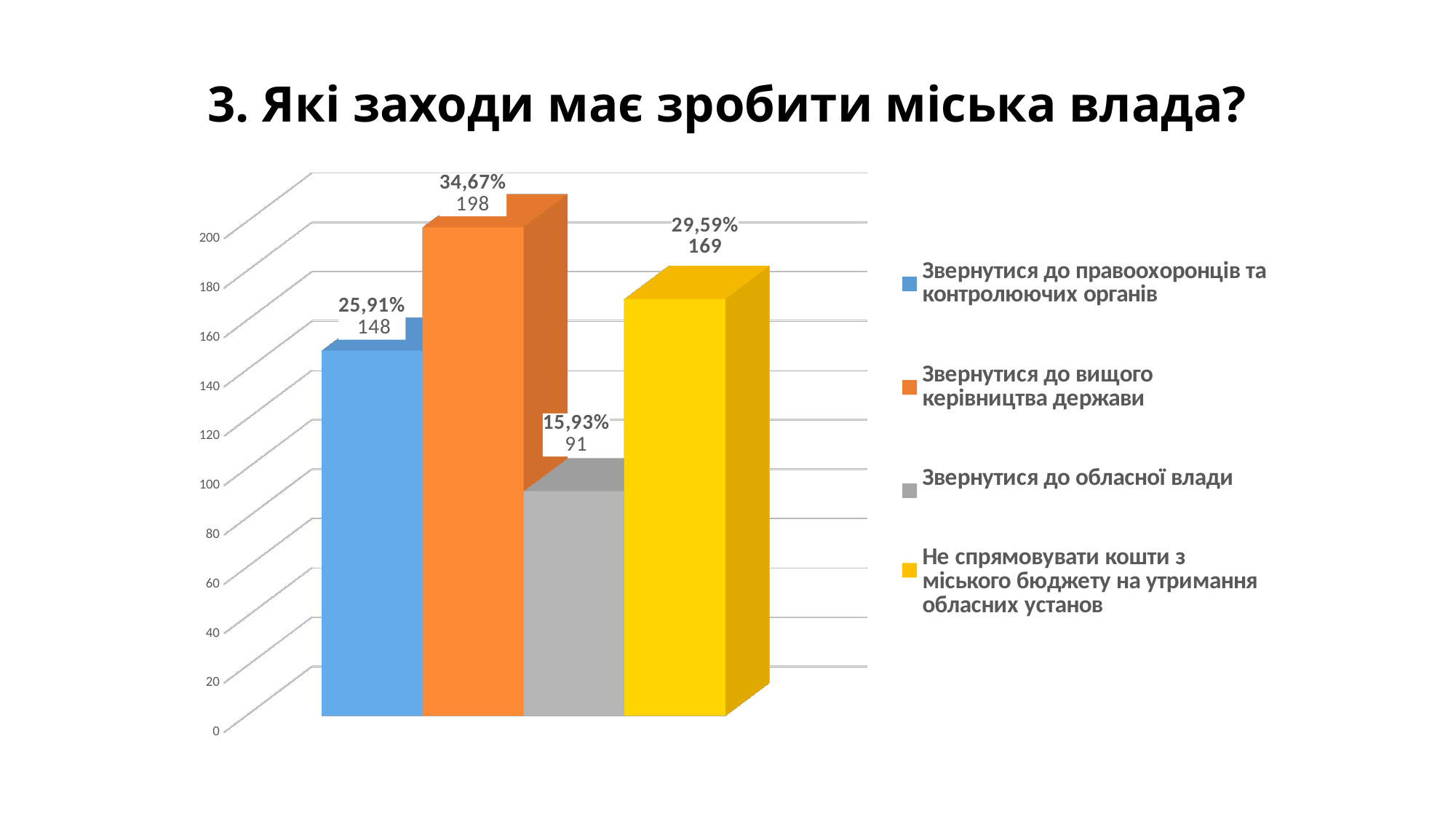
Which option has the lowest count? Звернутися до обласної влади How many bars are plotted in the chart? 4 Which option has the highest count? Звернутися до вищого керівництва держави How many entries does the legend list? 4 What percentage is shown for "Звернутися до вищого керівництва держави"? 34,67% What kind of chart is shown on the slide? Bar chart Which has a larger count: "Звернутися до правоохоронців та контролюючих органів" or "Не спрямовувати кошти з міського бюджету на утримання обласних установ"? Не спрямовувати кошти з міського бюджету на утримання обласних установ What is the difference in count between "Звернутися до вищого керівництва держави" and "Звернутися до обласної влади"? 107 What is the count shown for "Звернутися до обласної влади"? 91 What percentage is shown for "Не спрямовувати кошти з міського бюджету на утримання обласних установ"? 29,59% What is the count shown for "Звернутися до правоохоронців та контролюючих органів"? 148 What colour is the bar for "Звернутися до обласної влади"? Grey